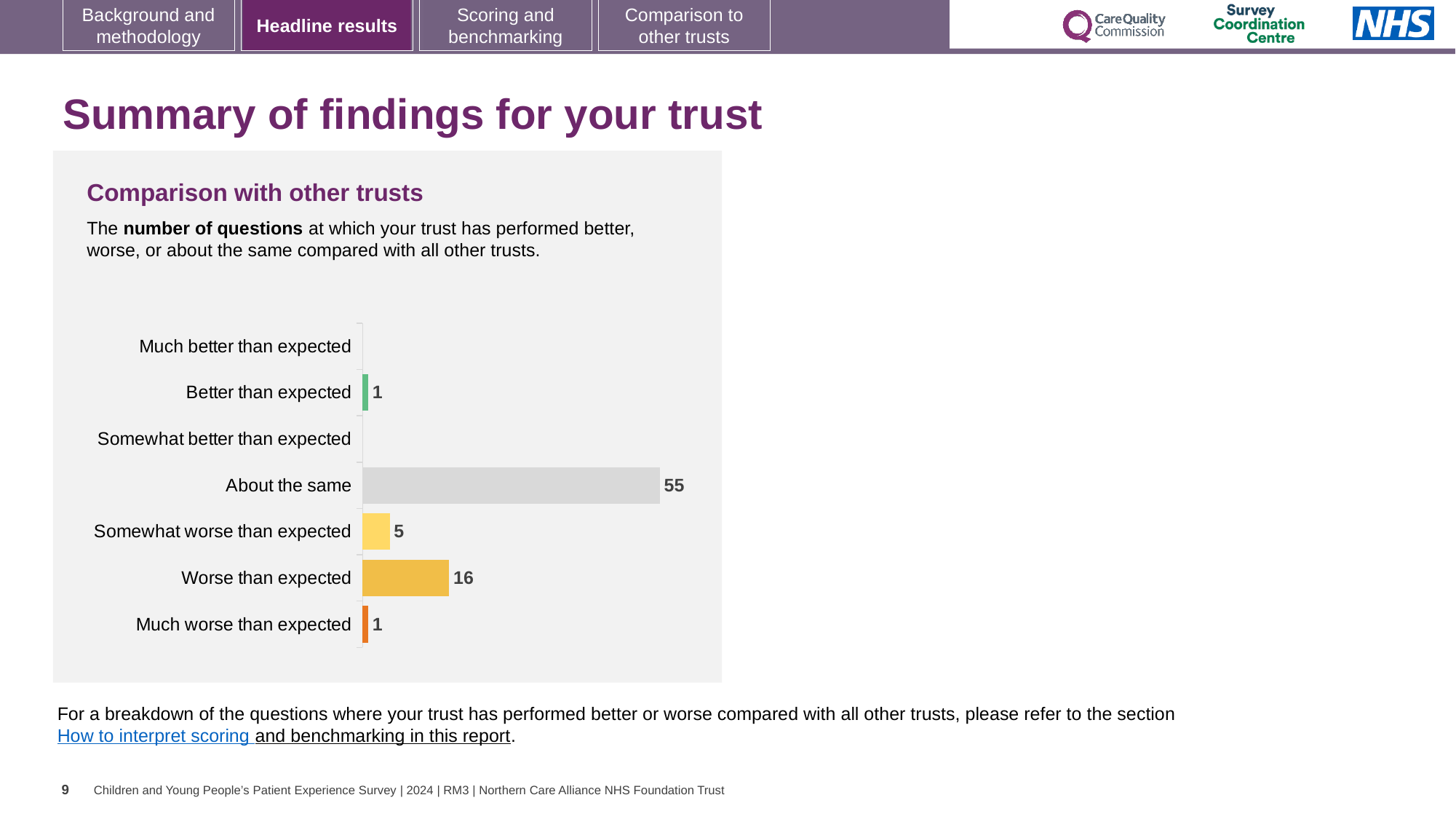
How many questions were rated 'About the same'? 55 Which is larger, 'Worse than expected' or 'Somewhat worse than expected'? Worse than expected Which category has the highest number of questions? About the same What is the difference between 'Worse than expected' and 'Somewhat worse than expected'? 11 What is the value for 'Worse than expected'? 16 What kind of chart is shown on the slide? Bar chart What colour is the bar for 'Better than expected'? Green What is the value for 'Somewhat worse than expected'? 5 What is the difference between 'About the same' and 'Worse than expected'? 39 How many categories are listed on the chart's axis? 7 What is the title of the chart section? Comparison with other trusts What is the value for 'Better than expected'? 1